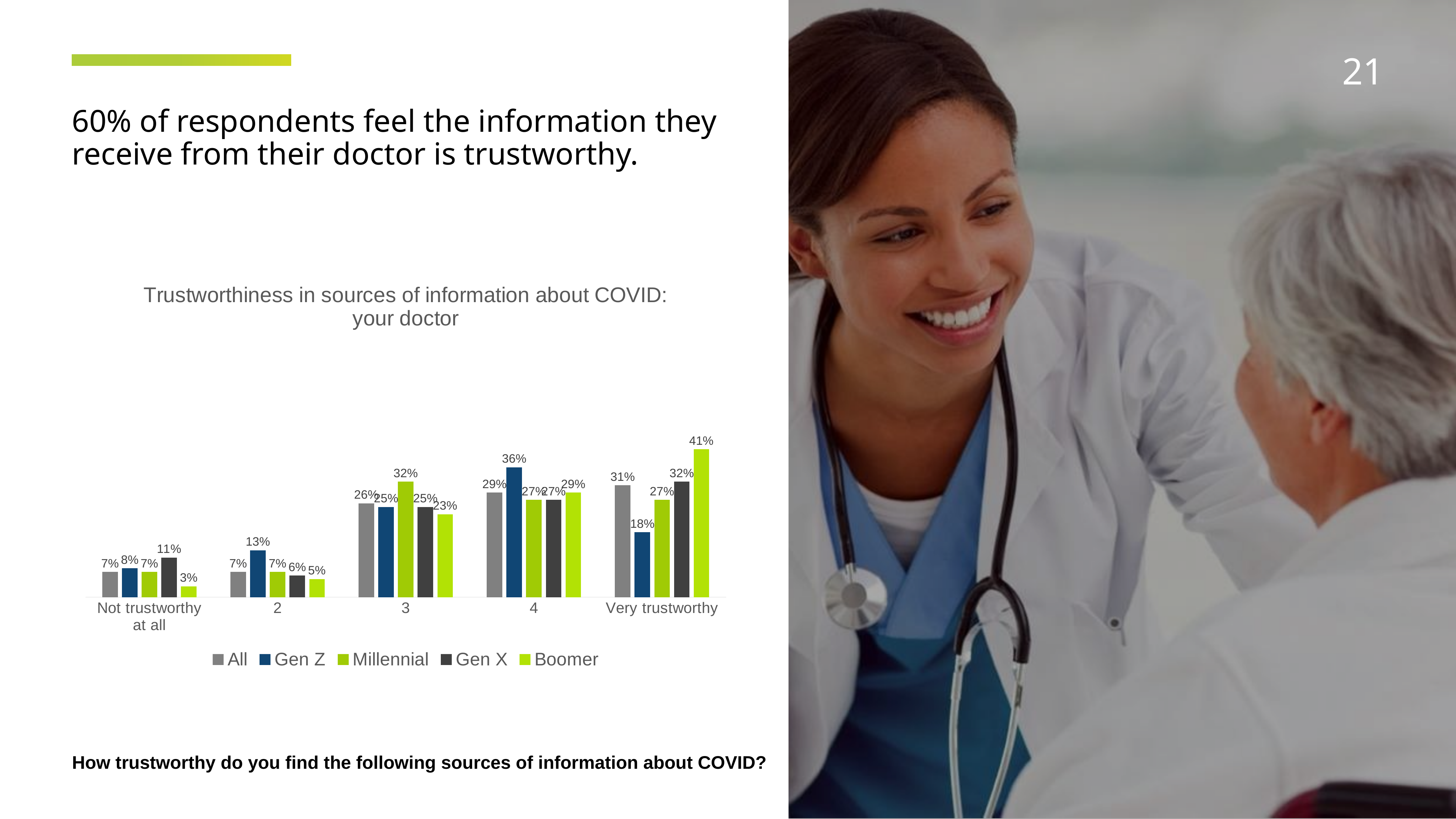
What is the title of the chart? Trustworthiness in sources of information about COVID: your doctor Which series has the highest value in the '2' category? Gen Z Which series has the lowest value in the 'Not trustworthy at all' category? Boomer What is the value for Gen X in the 'Not trustworthy at all' category? 11% What type of chart is shown on the slide? Bar chart What is the value for Boomer in the 'Very trustworthy' category? 41% Which series has the highest value in the 'Very trustworthy' category? Boomer What is the difference between the Boomer and Gen Z values in the 'Very trustworthy' category? 23% How many series does the legend list? 5 Which is larger in the '3' category: the Millennial value or the Gen X value? Millennial How many categories are shown on the x axis? 5 What is the value for Gen Z in the '4' category? 36%